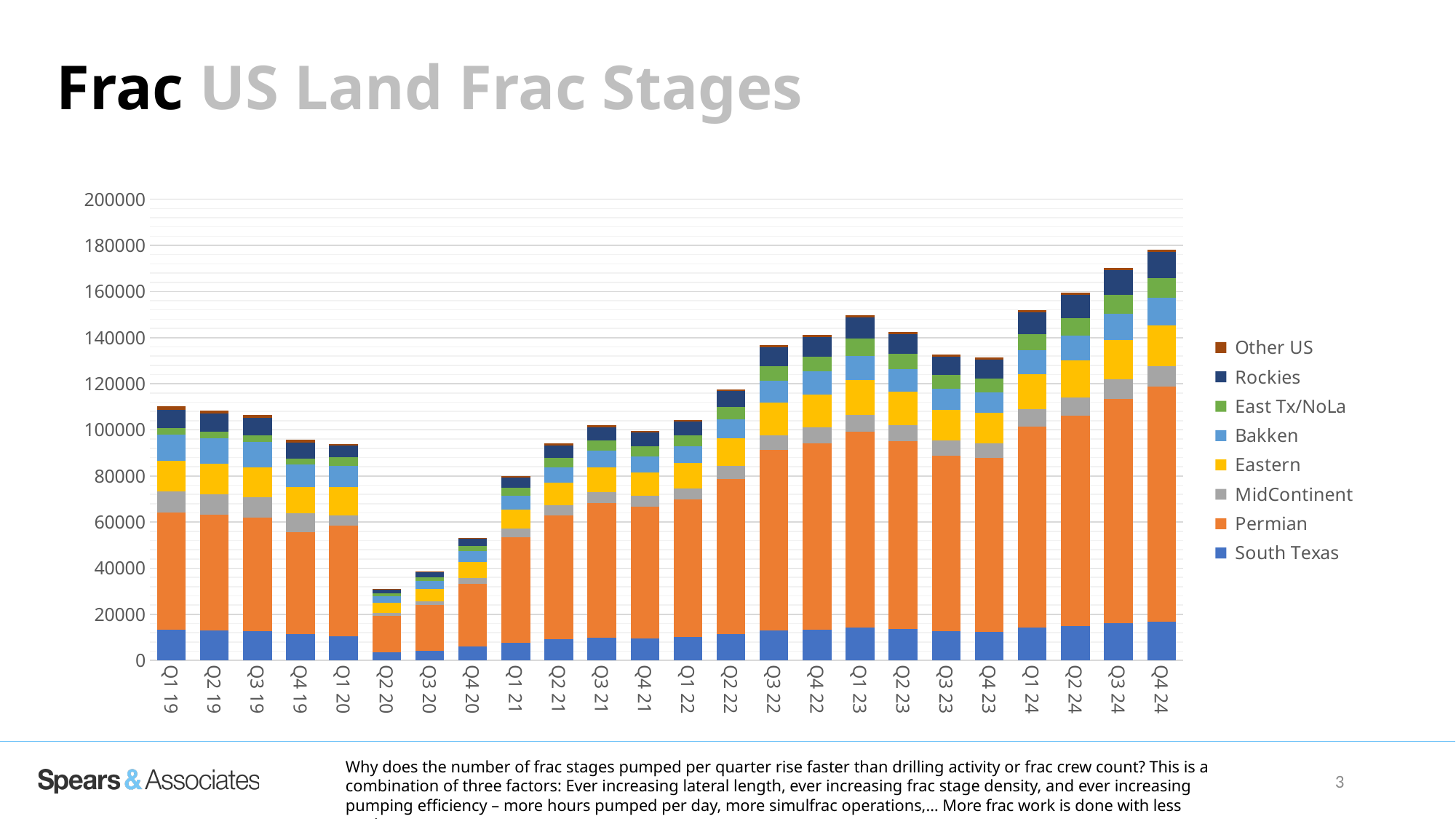
How many quarters are shown along the x axis of the chart? 24 Which quarter has a larger total, Q1 19 or Q4 19? Q1 19 Which quarter has the lowest total number of frac stages? Q2 20 Which series forms the bottom segment of each stacked bar? South Texas Do the total frac stages rise or fall from Q2 20 to Q1 23? rise Is the total for Q4 24 greater or less than 160000? greater What kind of chart is shown on the slide? Stacked bar chart How many series does the chart's legend list? 8 Which quarter has the highest total number of frac stages? Q4 24 Is the total for Q2 20 greater or less than 40000? less Is the total for Q1 23 greater or less than 140000? greater